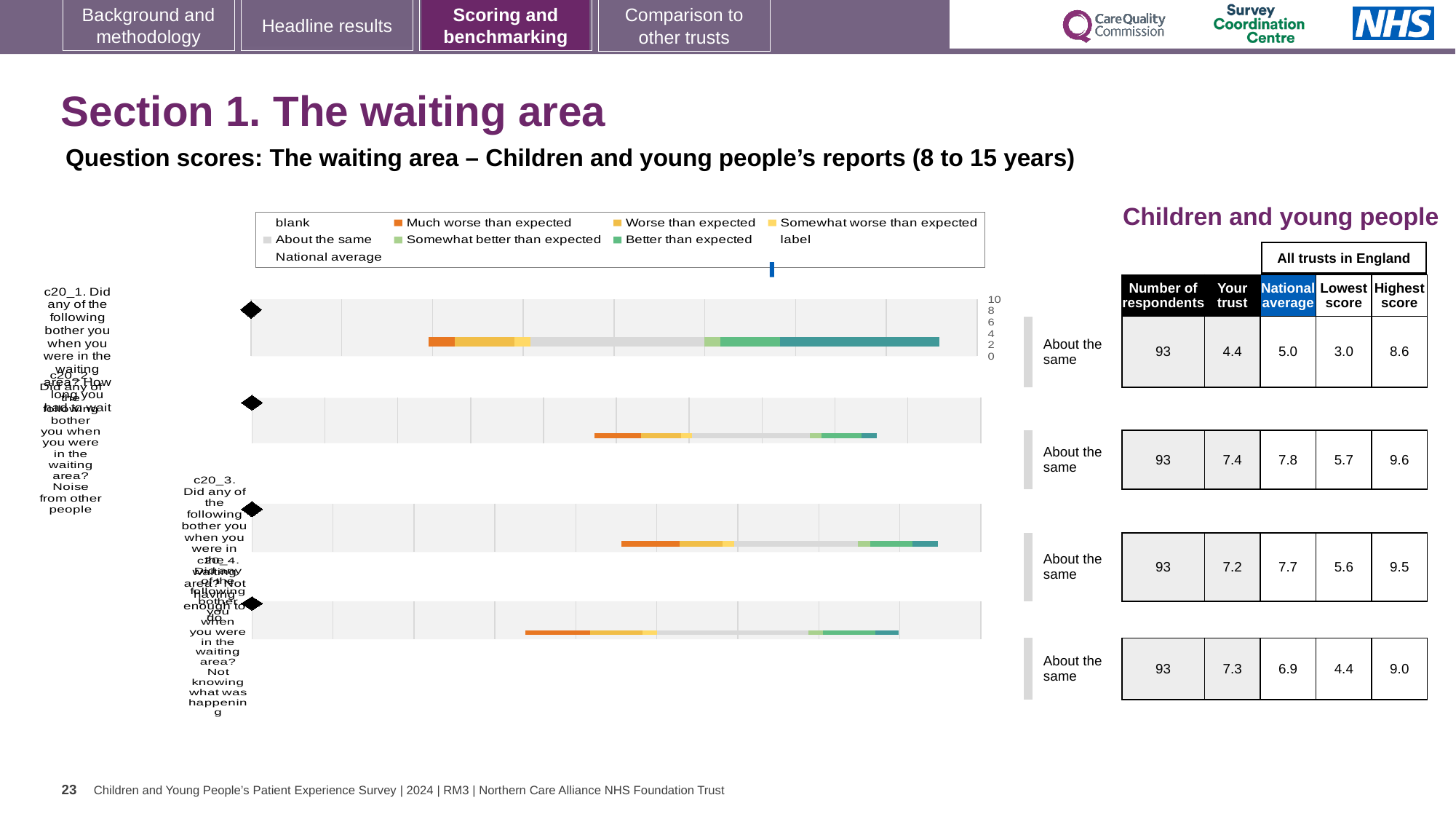
In the table beside the chart, what is the national average for the second row (c20_2)? 7.8 How many question rows (bars) are plotted in the chart? 4 What is the maximum value shown on the chart's score axis? 10 What colour represents 'Much worse than expected' in the chart legend? orange Which question row has the highest 'Your trust' score in the table? c20_2 Which question row has the lowest 'Your trust' score in the table? c20_1 What is the difference between the national average and the 'Your trust' score for the fourth row (c20_4)? 0.4 How many respondents are listed for each question in the table? 93 What is the highest score across all trusts in England for the fourth row (c20_4)? 9.0 For the first row (c20_1), which is larger: the 'Your trust' score or the national average? national average In the table beside the chart, what is the 'Your trust' score for the first row (c20_1)? 4.4 What kind of chart is shown on the slide? bar chart